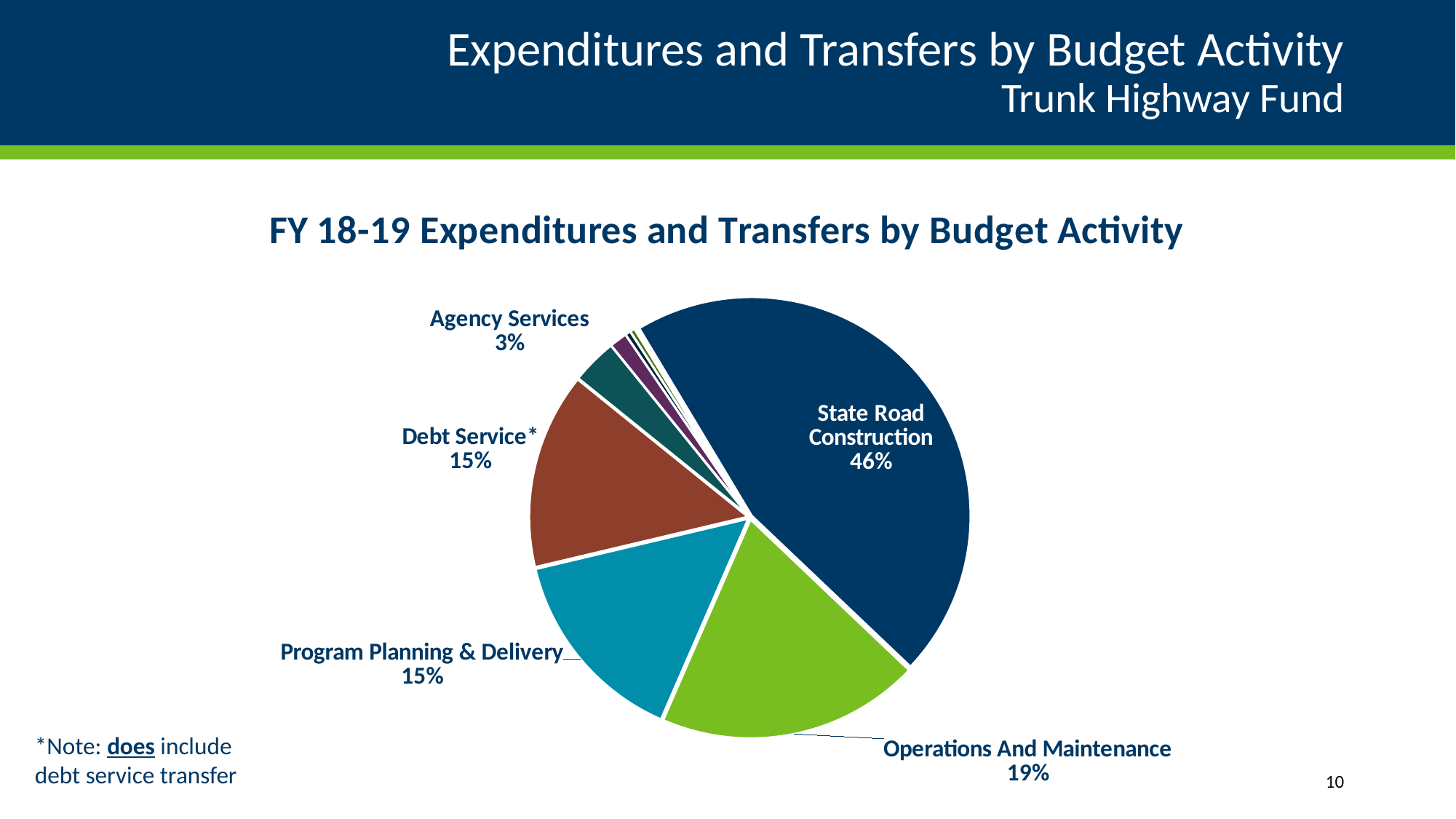
What share of the pie is Agency Services? 3% What share of the pie is State Road Construction? 46% What share of the pie is Debt Service*? 15% What is the title of the chart? FY 18-19 Expenditures and Transfers by Budget Activity How many percentage points larger is State Road Construction than Operations And Maintenance? 27 What share of the pie is Operations And Maintenance? 19% What kind of chart is shown on the slide? pie chart What share of the pie is Program Planning & Delivery? 15% Which is larger, Operations And Maintenance or Debt Service*? Operations And Maintenance Which labeled budget activity has the smallest share of the pie? Agency Services Which budget activity has the largest share of the pie? State Road Construction What colour is the State Road Construction slice? dark blue